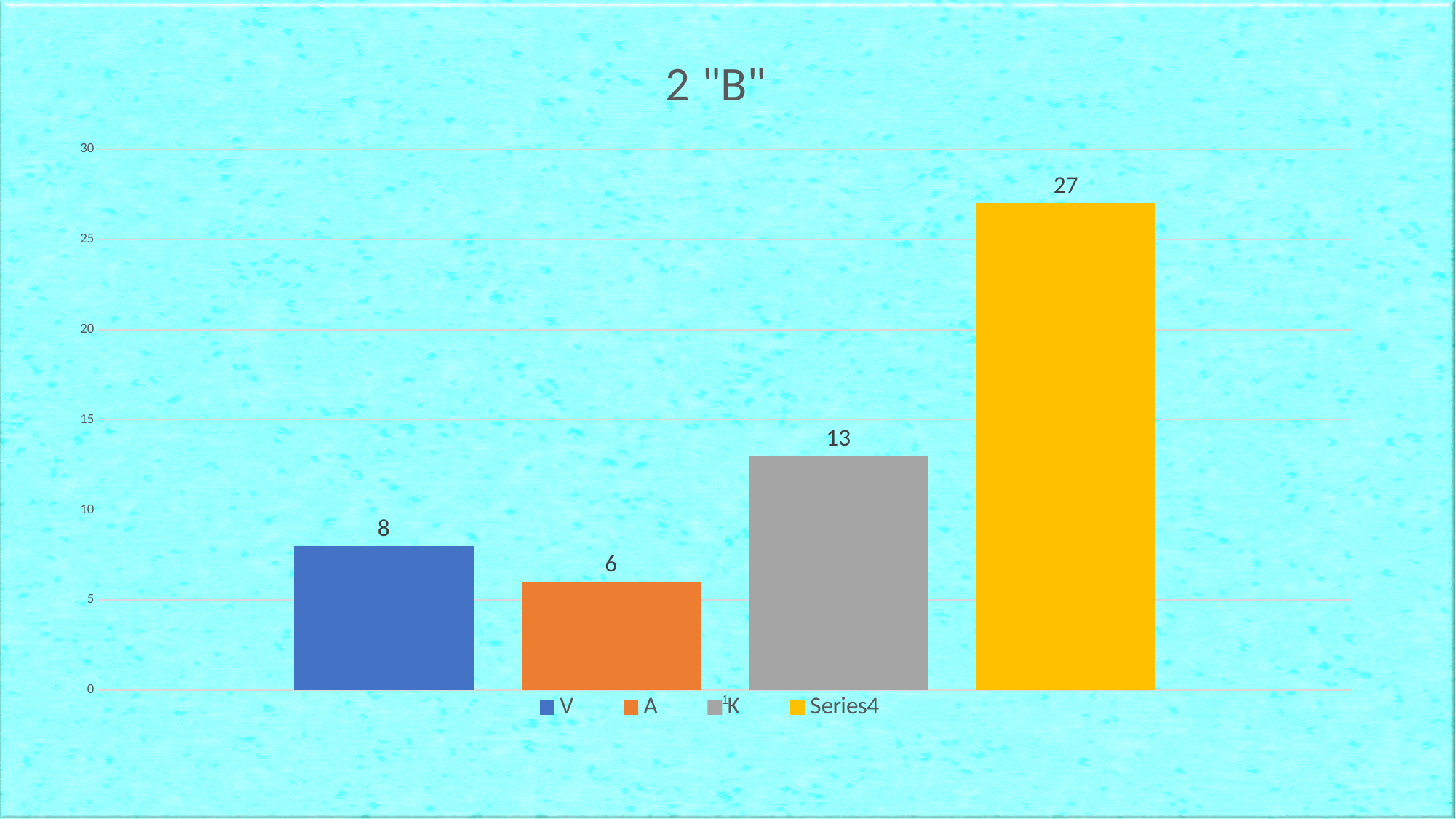
How many series does the legend list? 4 Which series has the lowest value? A What is the value for V? 8 What is the value for A? 6 What kind of chart is shown? Bar chart What is the title of the chart? 2 "B" What is the value for Series4? 27 Which is larger, the value for V or the value for K? K Which series has the highest value? Series4 What is the value for K? 13 What is the difference between the values for Series4 and K? 14 What is the difference between the values for V and A? 2